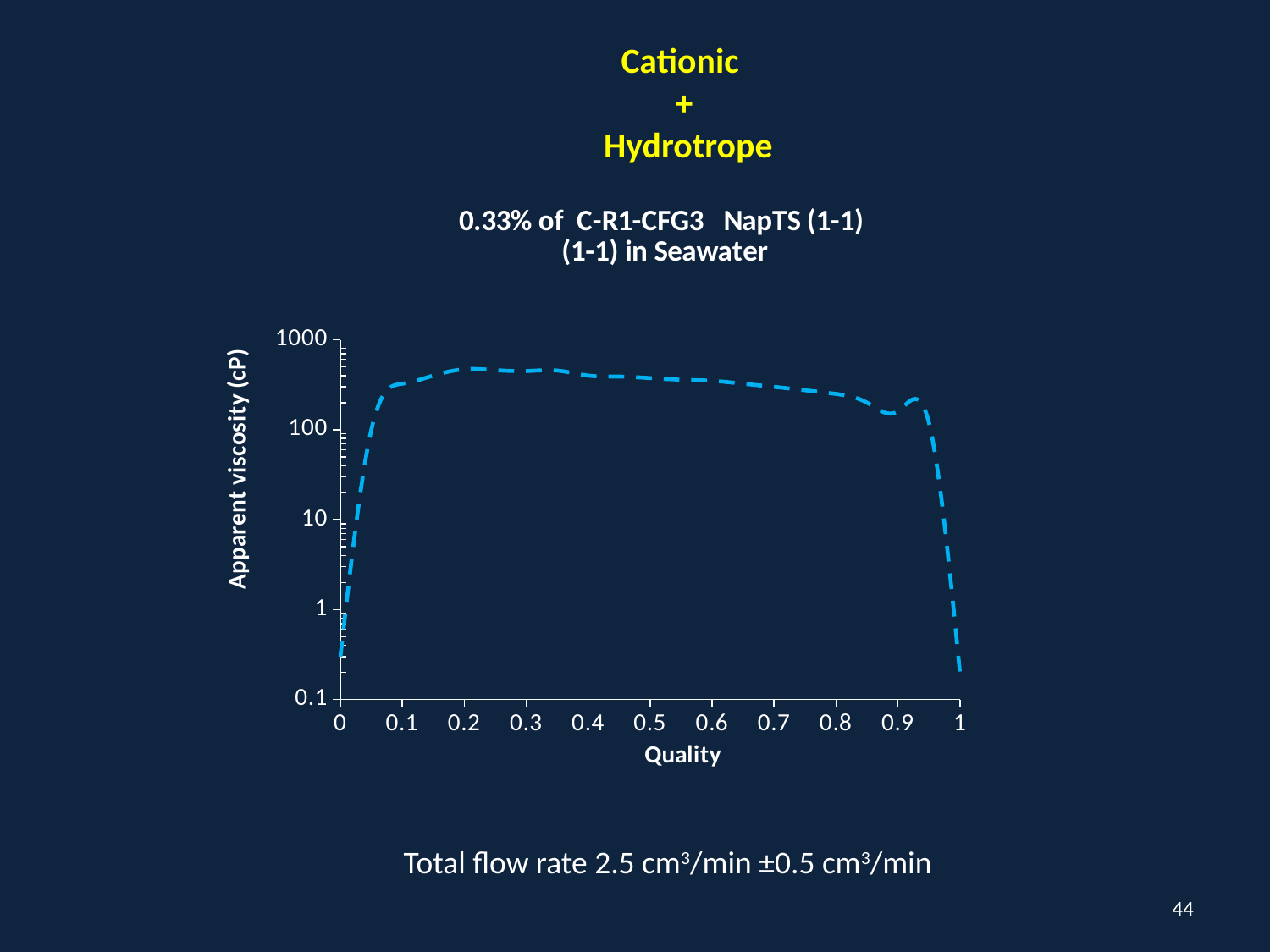
Is the apparent viscosity at a quality of 0.8 greater or less than 100? greater What is the label of the y axis? Apparent viscosity (cP) Between a quality of 0 and a quality of 0.1, does the apparent viscosity rise or fall? rise What kind of chart is shown on the slide? line chart Which is larger, the apparent viscosity at a quality of 0.2 or at a quality of 1? 0.2 Is the apparent viscosity at a quality of 0.2 greater or less than 1000? less Is the apparent viscosity at a quality of 1 greater or less than 1? less Between a quality of 0.3 and a quality of 0.9, does the apparent viscosity rise or fall? fall What is the highest value shown on the y axis? 1000 What is the title of the chart? 0.33% of C-R1-CFG3 NapTS (1-1) (1-1) in Seawater